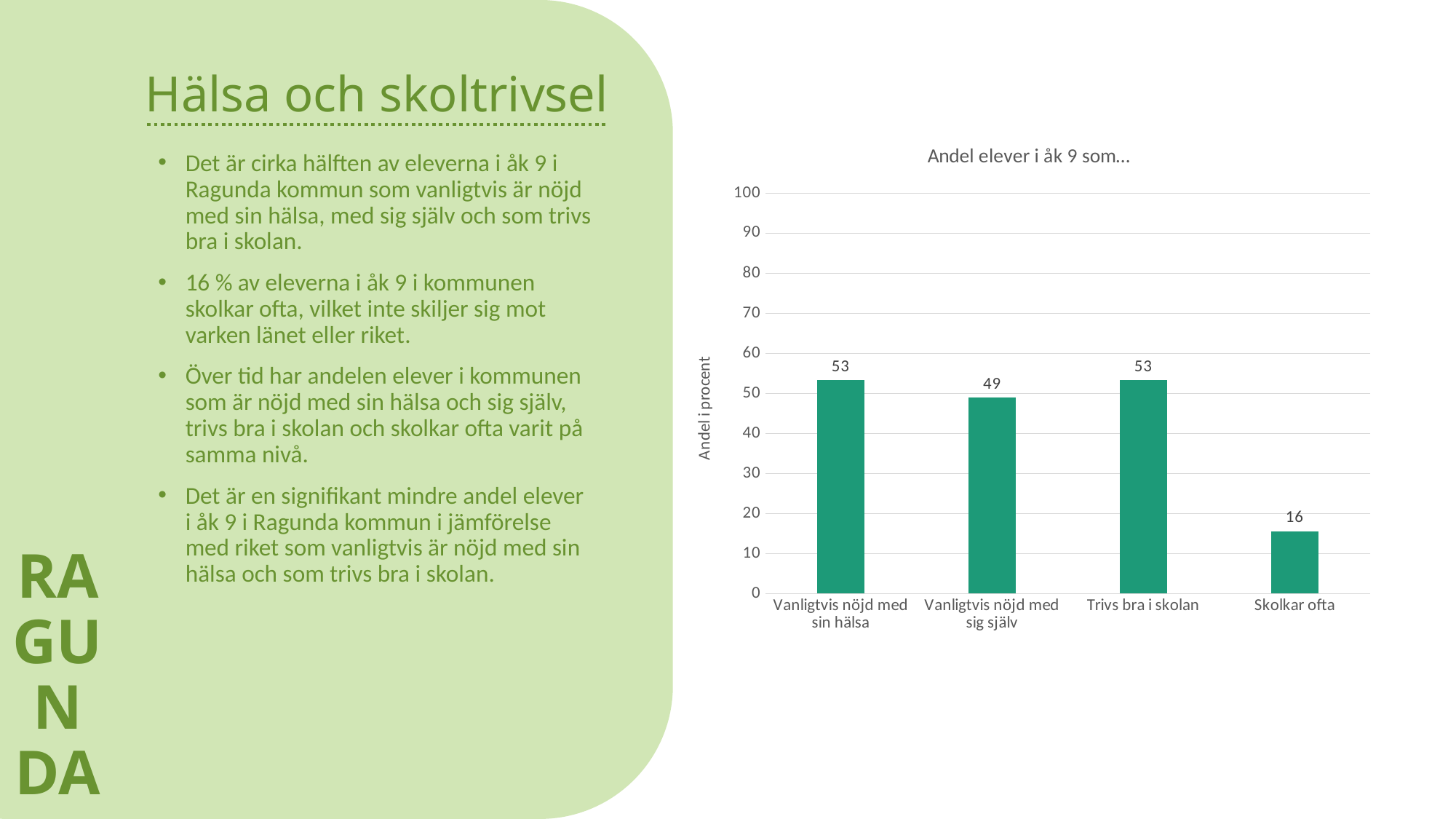
What is the title of the chart? Andel elever i åk 9 som… What is the difference between the values for "Trivs bra i skolan" and "Skolkar ofta"? 37 What is the value for "Trivs bra i skolan"? 53 What is the value for "Skolkar ofta"? 16 What is the value for "Vanligtvis nöjd med sig själv"? 49 How many categories are shown in the chart? 4 Which is larger, the value for "Vanligtvis nöjd med sig själv" or the value for "Skolkar ofta"? Vanligtvis nöjd med sig själv What is the difference between the values for "Vanligtvis nöjd med sin hälsa" and "Vanligtvis nöjd med sig själv"? 4 What is the value for "Vanligtvis nöjd med sin hälsa"? 53 What kind of chart is shown on the slide? bar chart Which category has the lowest value? Skolkar ofta Is the value for "Skolkar ofta" greater or less than 20? less